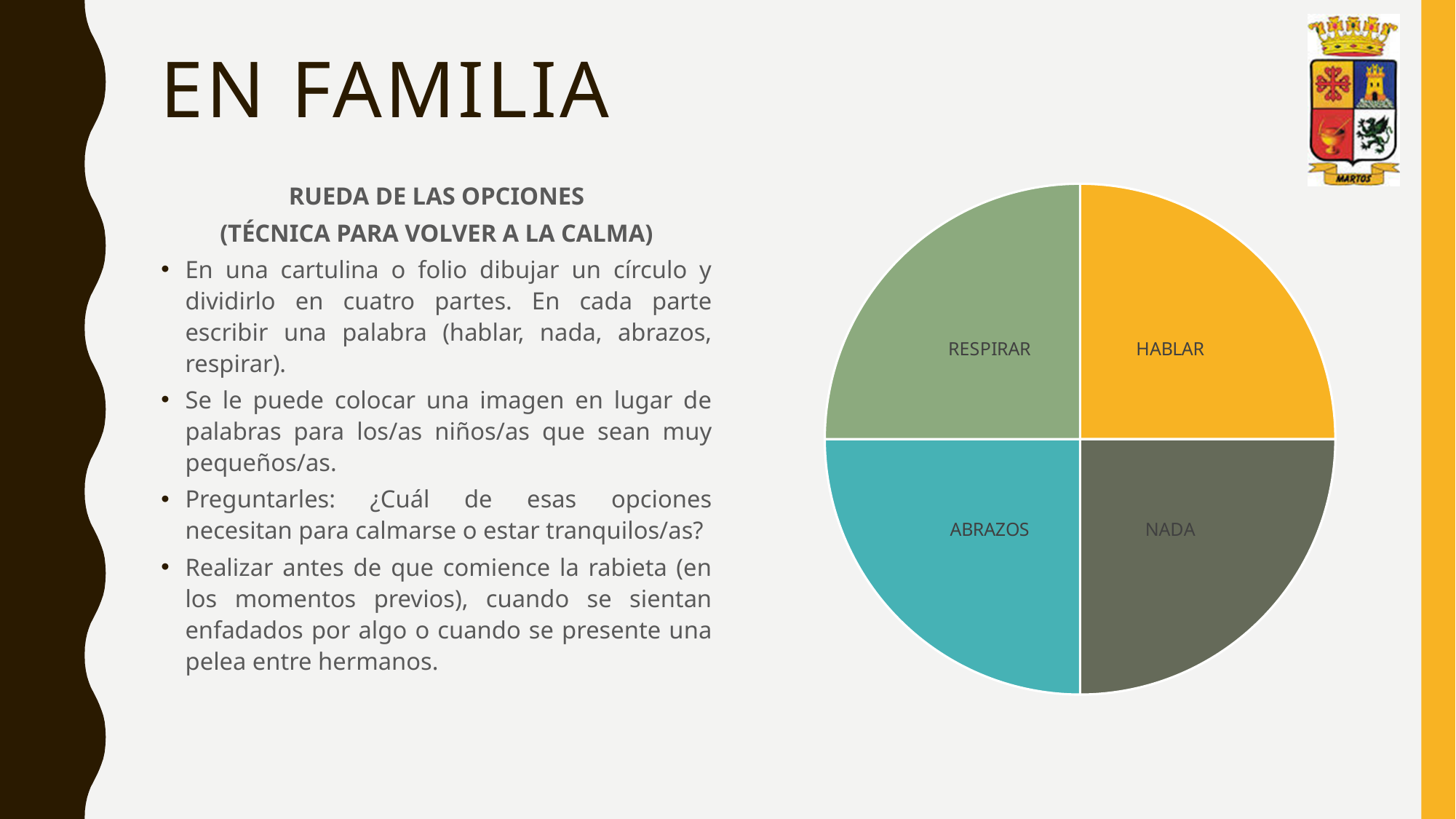
Which slice of the pie chart is in the bottom-left quarter? ABRAZOS Which slice of the pie chart is coloured yellow/orange? HABLAR Which slice of the pie chart is in the top-left quarter? RESPIRAR Is the HABLAR slice larger, smaller, or the same size as the NADA slice? The same size How many slices does the pie chart have? 4 What are the labels of the four slices in the pie chart? RESPIRAR, HABLAR, ABRAZOS, NADA What kind of chart is shown on the right of the slide? Pie chart Which slice of the pie chart is in the bottom-right quarter? NADA Are all four slices of the pie chart the same size? Yes